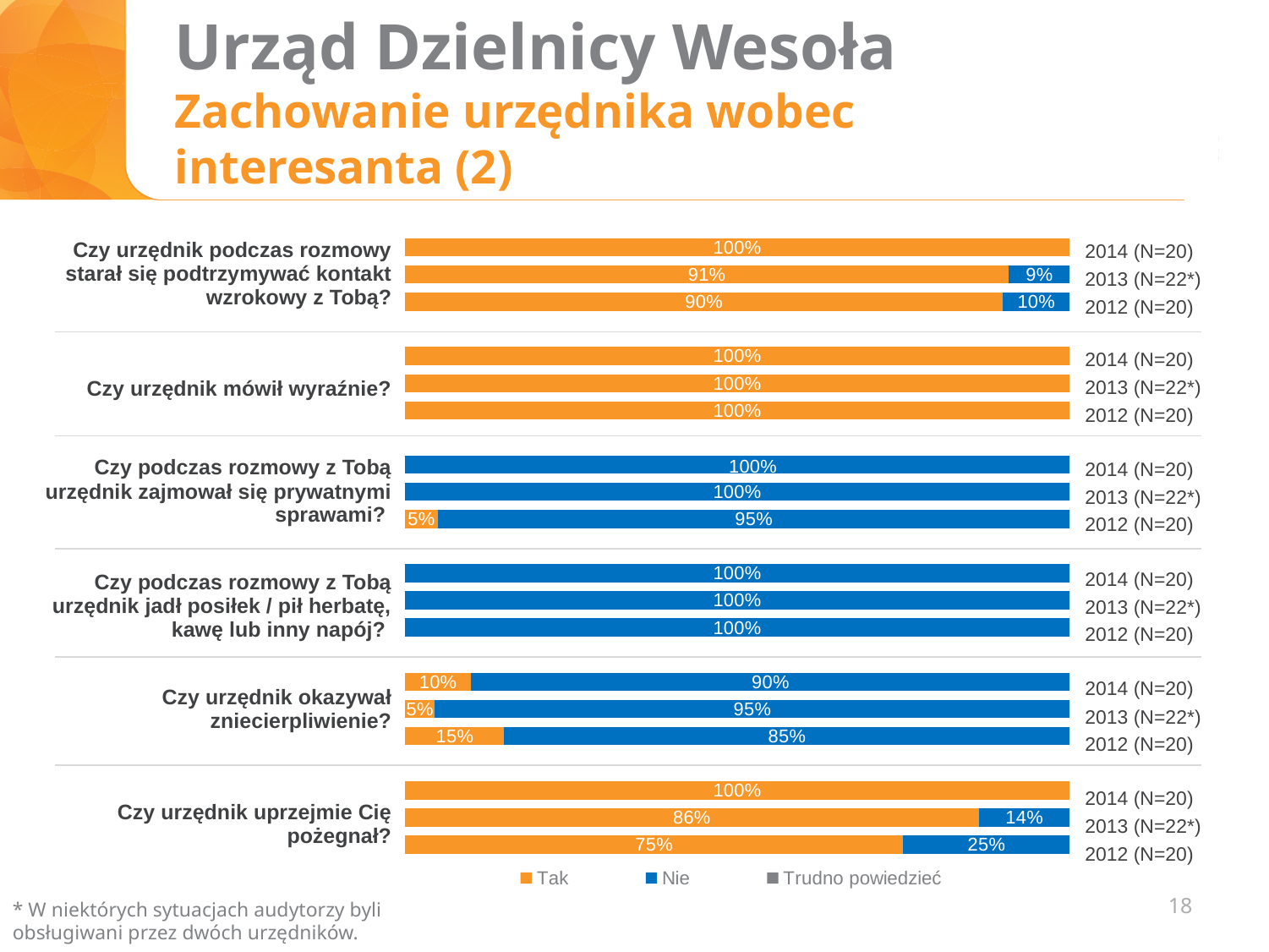
What is the 'Tak' value for 2012 (N=20) for the question 'Czy podczas rozmowy z Tobą urzędnik zajmował się prywatnymi sprawami?' 5% How many series does the legend list? 3 For the question 'Czy urzędnik okazywał zniecierpliwienie?', which year has the larger 'Tak' value: 2012 (N=20) or 2014 (N=20)? 2012 (N=20) How many years are shown for each question? 3 What is the 'Nie' value for 2014 (N=20) for the question 'Czy urzędnik okazywał zniecierpliwienie?' 90% What is the 'Tak' value for 2012 (N=20) for the question 'Czy urzędnik uprzejmie Cię pożegnał?' 75% For the question 'Czy urzędnik uprzejmie Cię pożegnał?', what is the difference in percentage points between the 'Tak' value for 2014 (N=20) and for 2012 (N=20)? 25 percentage points For the question 'Czy urzędnik uprzejmie Cię pożegnał?', does the 'Tak' value rise or fall from 2012 to 2014? rise Which colour represents 'Tak' in the legend? orange For the question 'Czy urzędnik uprzejmie Cię pożegnał?', which year has the highest 'Nie' value? 2012 (N=20) What is the 'Nie' value for 2013 (N=22*) for the question 'Czy urzędnik podczas rozmowy starał się podtrzymywać kontakt wzrokowy z Tobą?' 9% What kind of chart is shown on the slide? bar chart